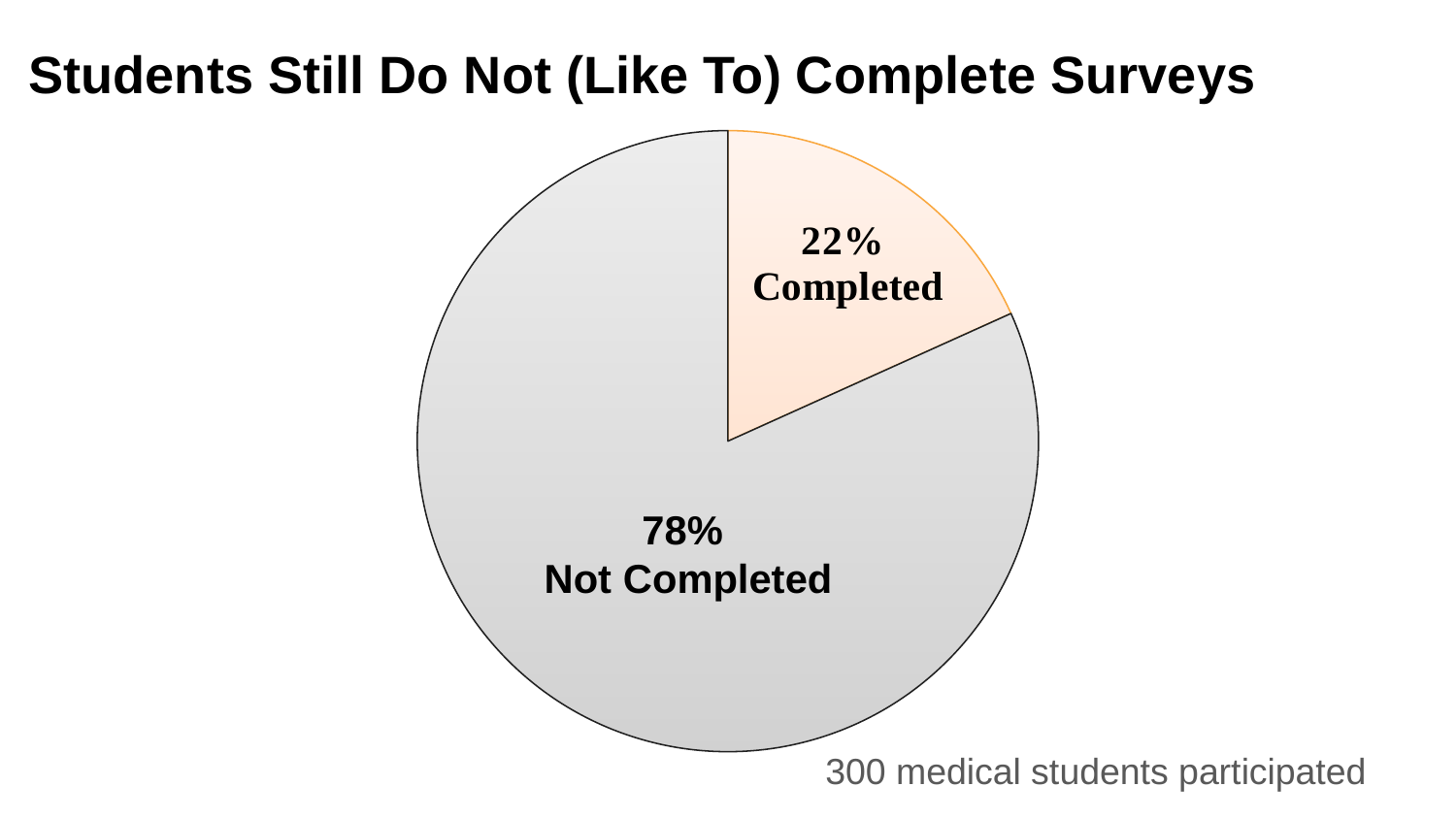
Which slice is the smallest? Completed What is the title of the slide? Students Still Do Not (Like To) Complete Surveys What share of students completed the survey? 22% What kind of chart is shown on the slide? pie chart Which slice is the largest? Not Completed How many slices does the pie chart have? 2 How many medical students participated, according to the note on the slide? 300 Which is larger, the Completed slice or the Not Completed slice? Not Completed What is the difference in percentage points between Not Completed and Completed? 56 What share of students did not complete the survey? 78%